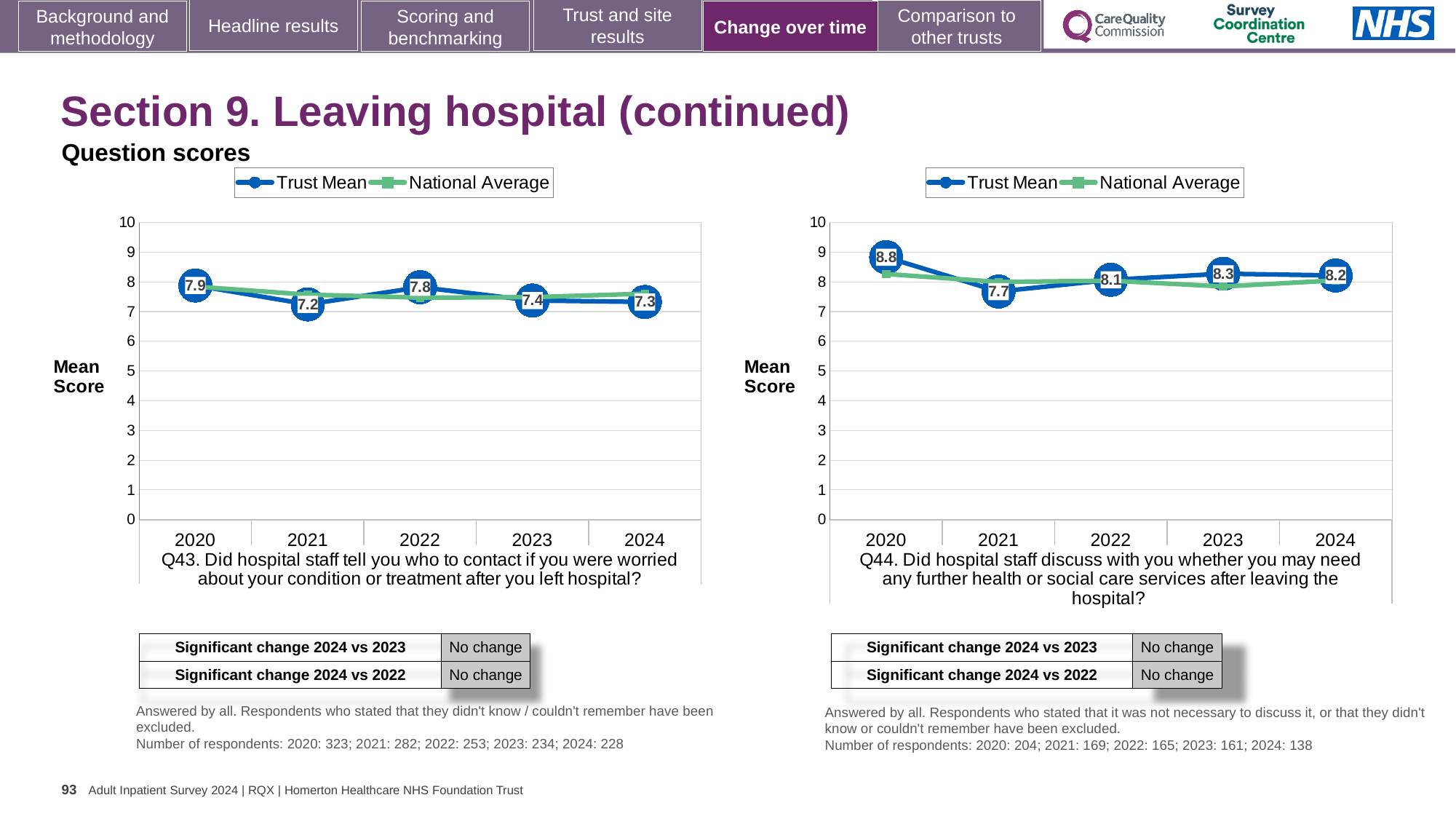
How many years are plotted on the x axis of the Q43 chart (left)? 5 In the Q43 chart (left), which year has the lowest Trust Mean score? 2021 What type of chart is used for the Q43 chart (left)? Line chart In the Q44 chart (right), what is the difference between the Trust Mean scores for 2020 and 2021? 1.1 In the Q44 chart (right), which year has the highest Trust Mean score? 2020 In the Q43 chart (left), what is the difference between the Trust Mean scores for 2020 and 2021? 0.7 In the Q43 chart (left), what is the Trust Mean score for 2024? 7.3 How many series does the legend of the Q44 chart (right) list? 2 In the Q43 chart (left), what is the Trust Mean score for 2020? 7.9 In the Q44 chart (right), what is the Trust Mean score for 2020? 8.8 In the Q44 chart (right), what is the Trust Mean score for 2023? 8.3 In the Q44 chart (right), is the Trust Mean score for 2021 higher or lower than the Trust Mean score for 2022? lower